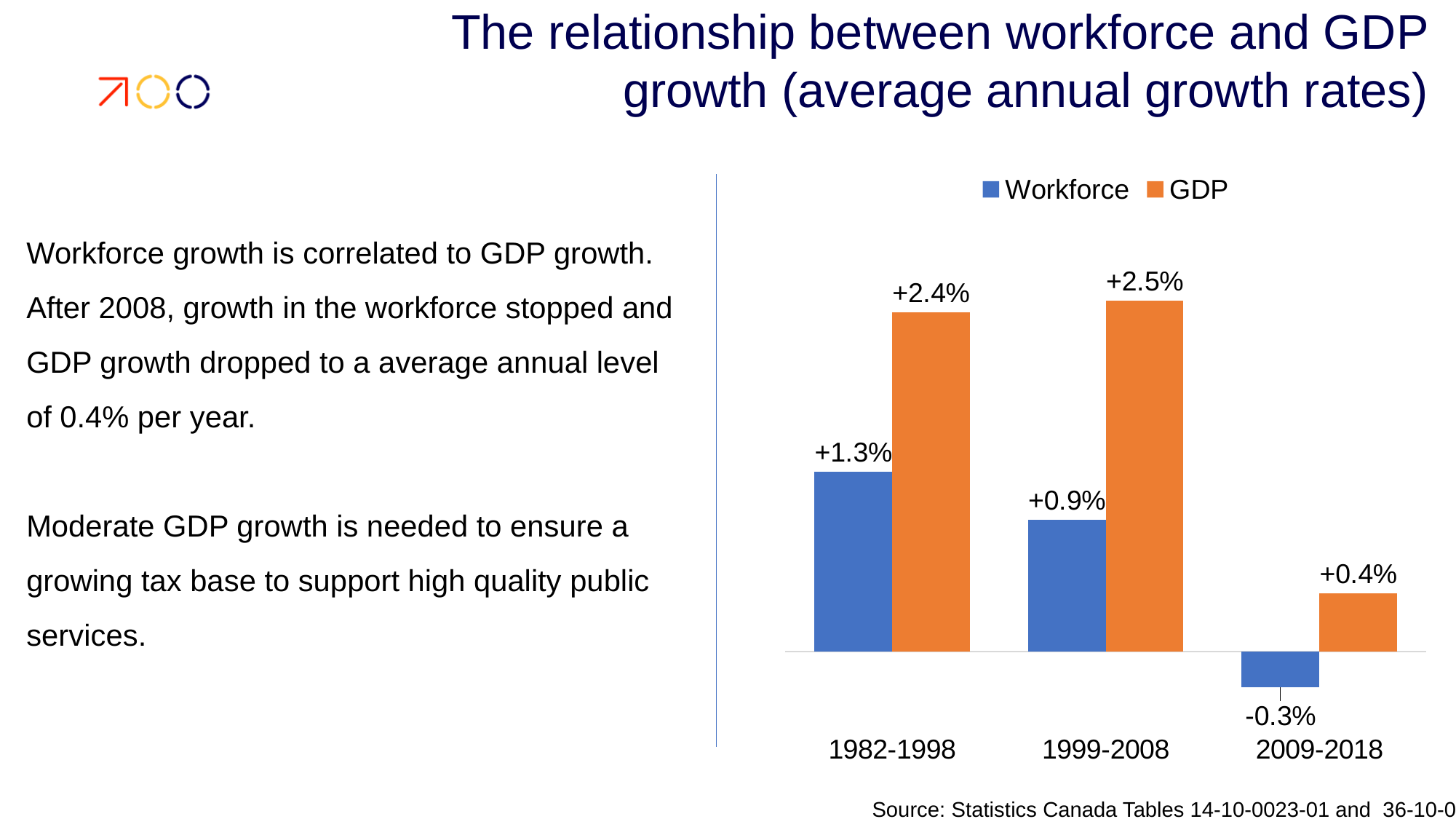
What is the GDP growth rate for 1999-2008? +2.5% What kind of chart is shown on the slide? Bar chart How many periods are shown on the x axis? 3 How many series does the legend list? 2 Which period has the highest GDP growth rate? 1999-2008 What is the Workforce growth rate for 1982-1998? +1.3% Which is larger for 1999-2008, the Workforce growth rate or the GDP growth rate? GDP What is the Workforce growth rate for 2009-2018? -0.3% What is the difference between the GDP growth rate and the Workforce growth rate for 1982-1998? 1.1% Which period has the lowest Workforce growth rate? 2009-2018 Which colour represents GDP in the chart? Orange What is the GDP growth rate for 2009-2018? +0.4%